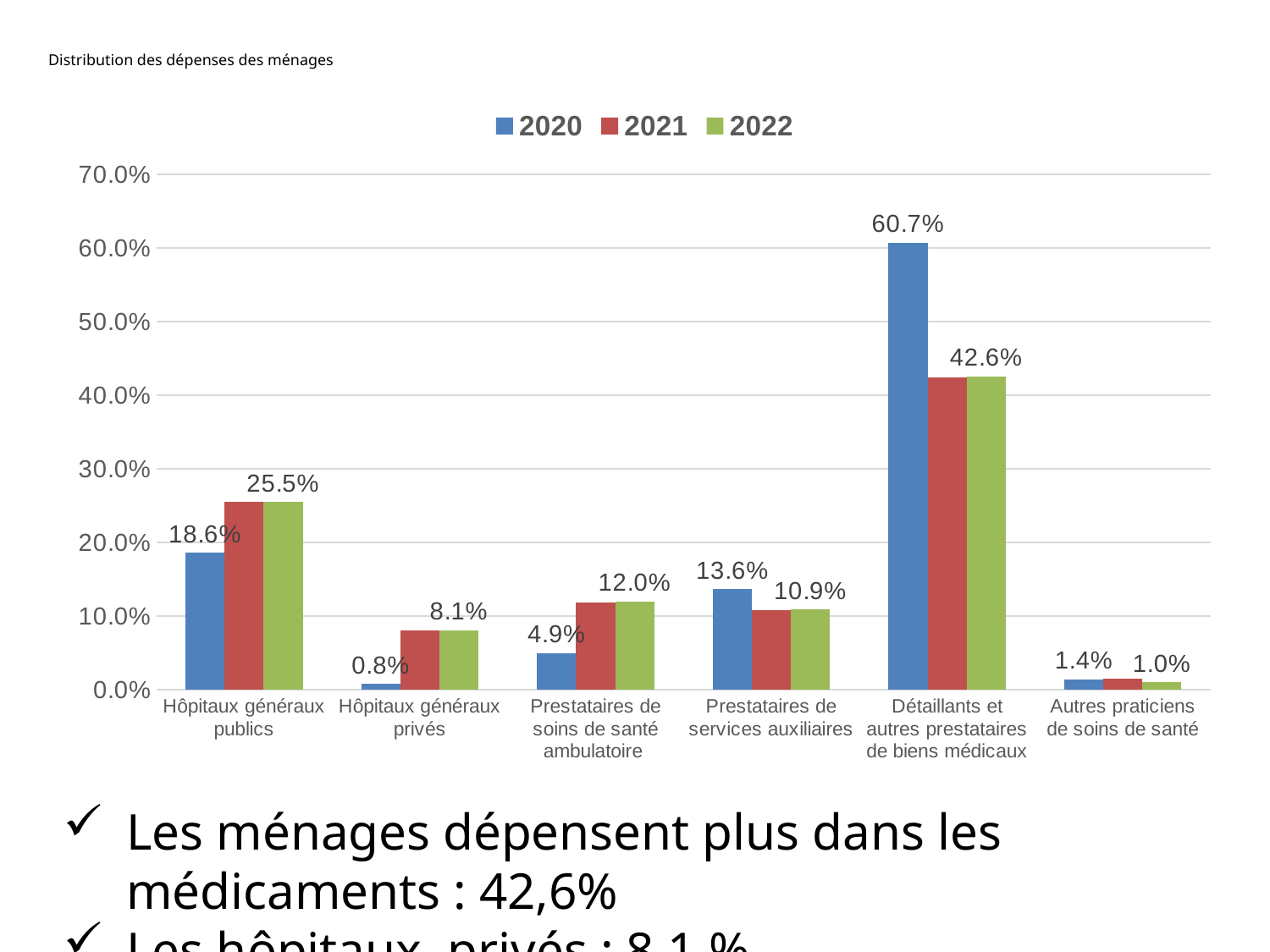
How many categories are shown on the x axis? 6 What is the 2020 value for Détaillants et autres prestataires de biens médicaux? 60.7% What is the 2022 value for Prestataires de services auxiliaires? 10.9% What is the difference between the 2022 and 2020 values for Prestataires de soins de santé ambulatoire? 7.1 percentage points How many series does the legend list? 3 What is the difference between the 2020 and 2022 values for Détaillants et autres prestataires de biens médicaux? 18.1 percentage points What kind of chart is shown on the slide? bar chart For Hôpitaux généraux publics, which is larger: the 2020 value or the 2022 value? 2022 Is the 2021 value for Détaillants et autres prestataires de biens médicaux greater or less than 50.0%? less What is the 2022 value for Hôpitaux généraux privés? 8.1% Which category has the lowest 2020 value? Hôpitaux généraux privés Which category has the highest 2020 value? Détaillants et autres prestataires de biens médicaux